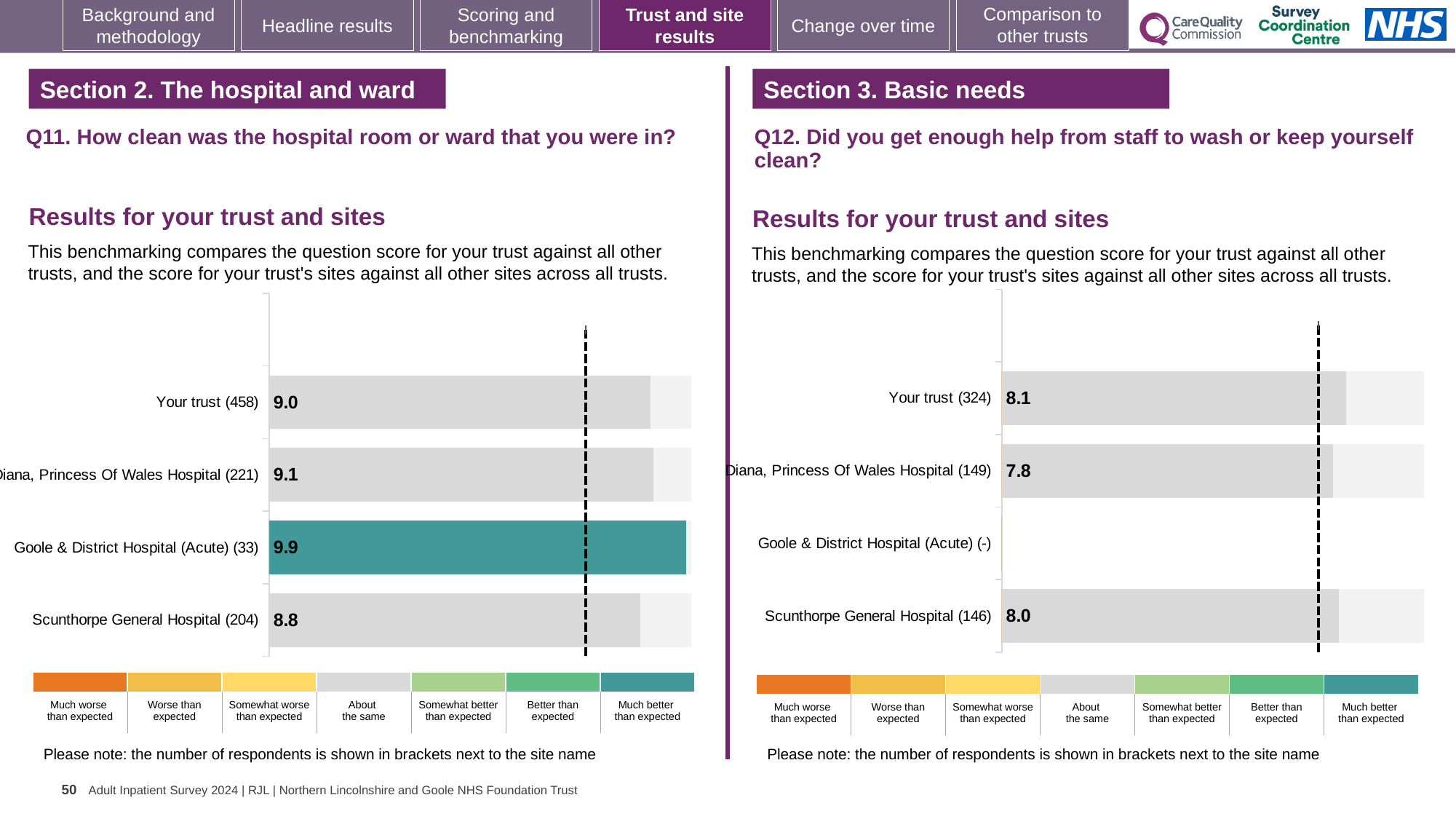
In the Q12 chart on the right, what is the score for Diana, Princess Of Wales Hospital? 7.8 In the Q12 chart on the right, which is larger, the score for Your trust or the score for Scunthorpe General Hospital? Your trust In the Q11 chart on the left, what is the score for Goole & District Hospital (Acute)? 9.9 In the Q12 chart on the right, what is the score for Your trust? 8.1 In the Q11 chart on the left, how many respondents are shown for Your trust? 458 What type of chart is used for the Q11 results on the left? Bar chart In the Q12 chart on the right, what is the difference between the scores for Your trust and Diana, Princess Of Wales Hospital? 0.3 In the Q11 chart on the left, what is the score for Scunthorpe General Hospital? 8.8 In the Q12 chart on the right, how many rows (sites including Your trust) are listed? 4 In the Q11 chart on the left, which site has the lowest score? Scunthorpe General Hospital In the Q11 chart on the left, which site has the highest score? Goole & District Hospital (Acute) In the Q11 chart on the left, what is the difference between the scores for Goole & District Hospital (Acute) and Your trust? 0.9